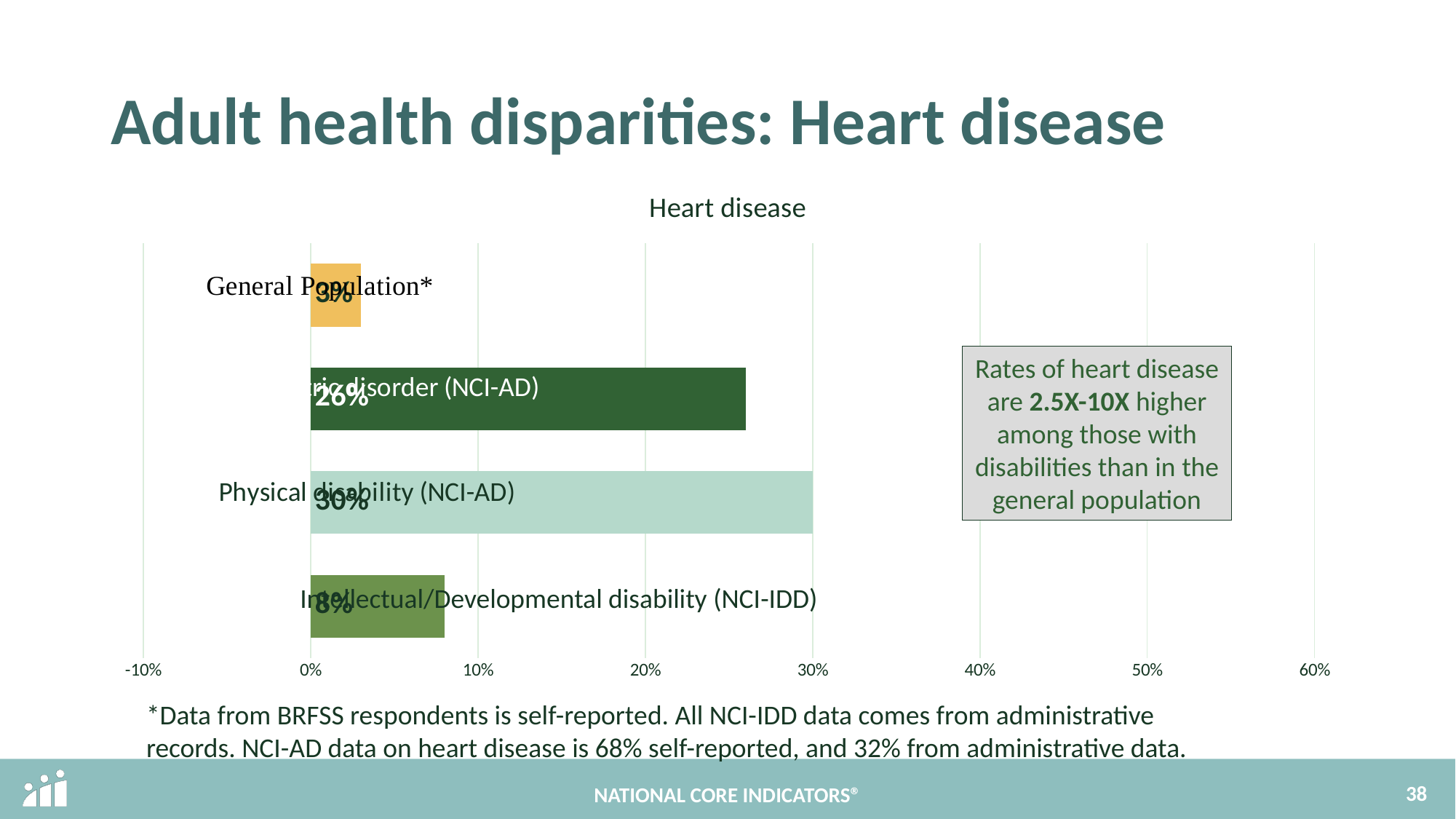
How many bars are plotted in the chart? 4 Which category has the lowest heart disease rate? General Population* What kind of chart is shown on the slide? Bar chart What value is labelled on the dark green bar, the second bar from the top? 26% Which is larger: the heart disease rate for Intellectual/Developmental disability (NCI-IDD) or for the General Population*? Intellectual/Developmental disability (NCI-IDD) Which category has the highest heart disease rate? Physical disability (NCI-AD) What is the difference between the heart disease rate for Intellectual/Developmental disability (NCI-IDD) and the General Population*? 5% Is the value for Physical disability (NCI-AD) greater or less than 20%? greater What is the heart disease rate shown for Intellectual/Developmental disability (NCI-IDD)? 8% What is the heart disease rate shown for the General Population*? 3% What is the heart disease rate shown for Physical disability (NCI-AD)? 30% What is the difference between the heart disease rate for Physical disability (NCI-AD) and the General Population*? 27%